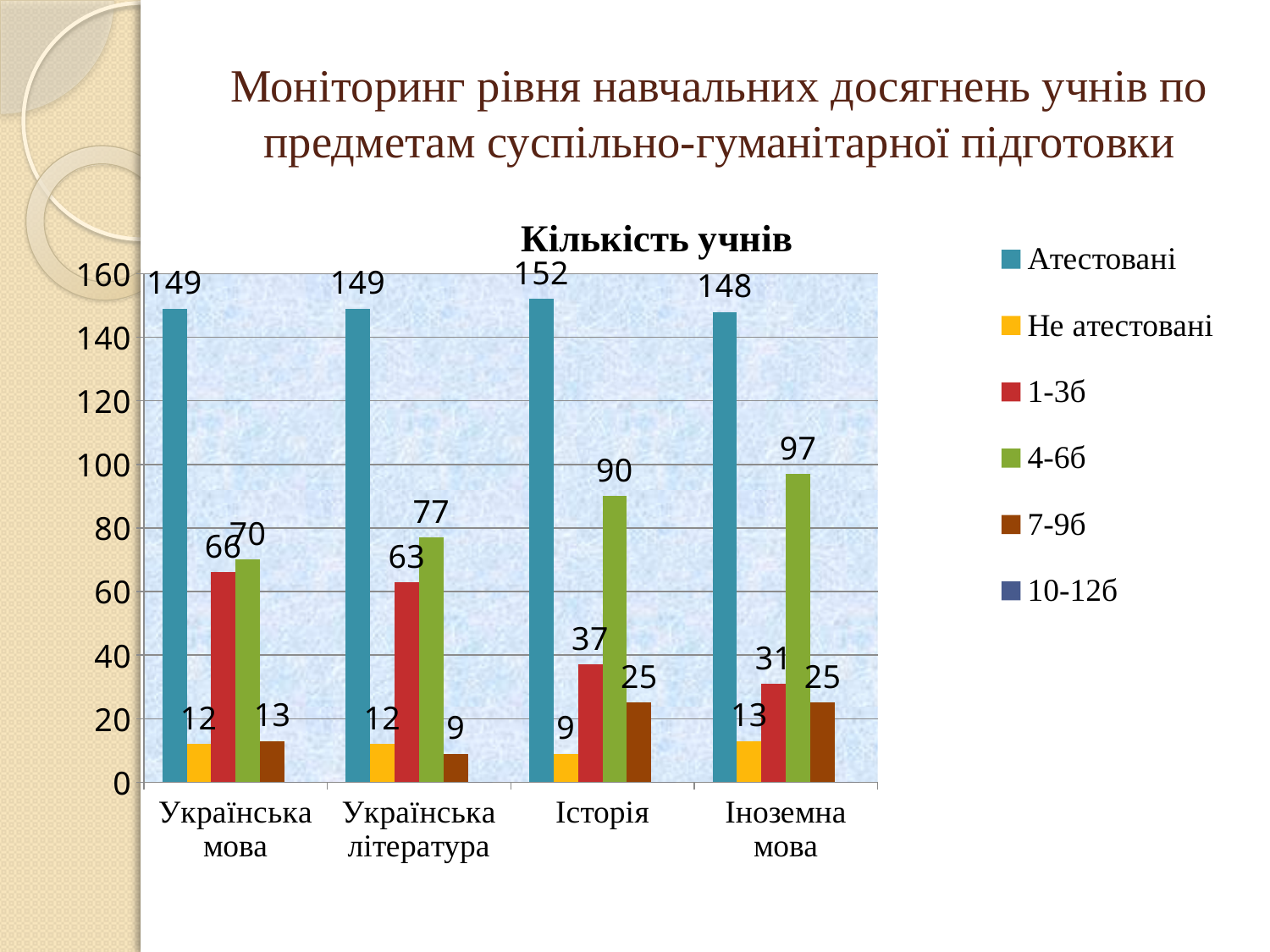
What is the difference between the 4-6б values for Іноземна мова and Українська мова? 27 Which category has the highest value for Атестовані? Історія What is the value for 1-3б in Українська література? 63 What is the value for Атестовані in Історія? 152 How many categories are shown on the x axis? 4 How many series does the legend list? 6 What is the value for 7-9б in Українська мова? 13 What is the value for 4-6б in Іноземна мова? 97 Which is larger: the 1-3б value for Історія or the 1-3б value for Іноземна мова? Історія What kind of chart is this? bar chart What is the title of the chart? Кількість учнів Which category has the lowest value for 1-3б? Іноземна мова